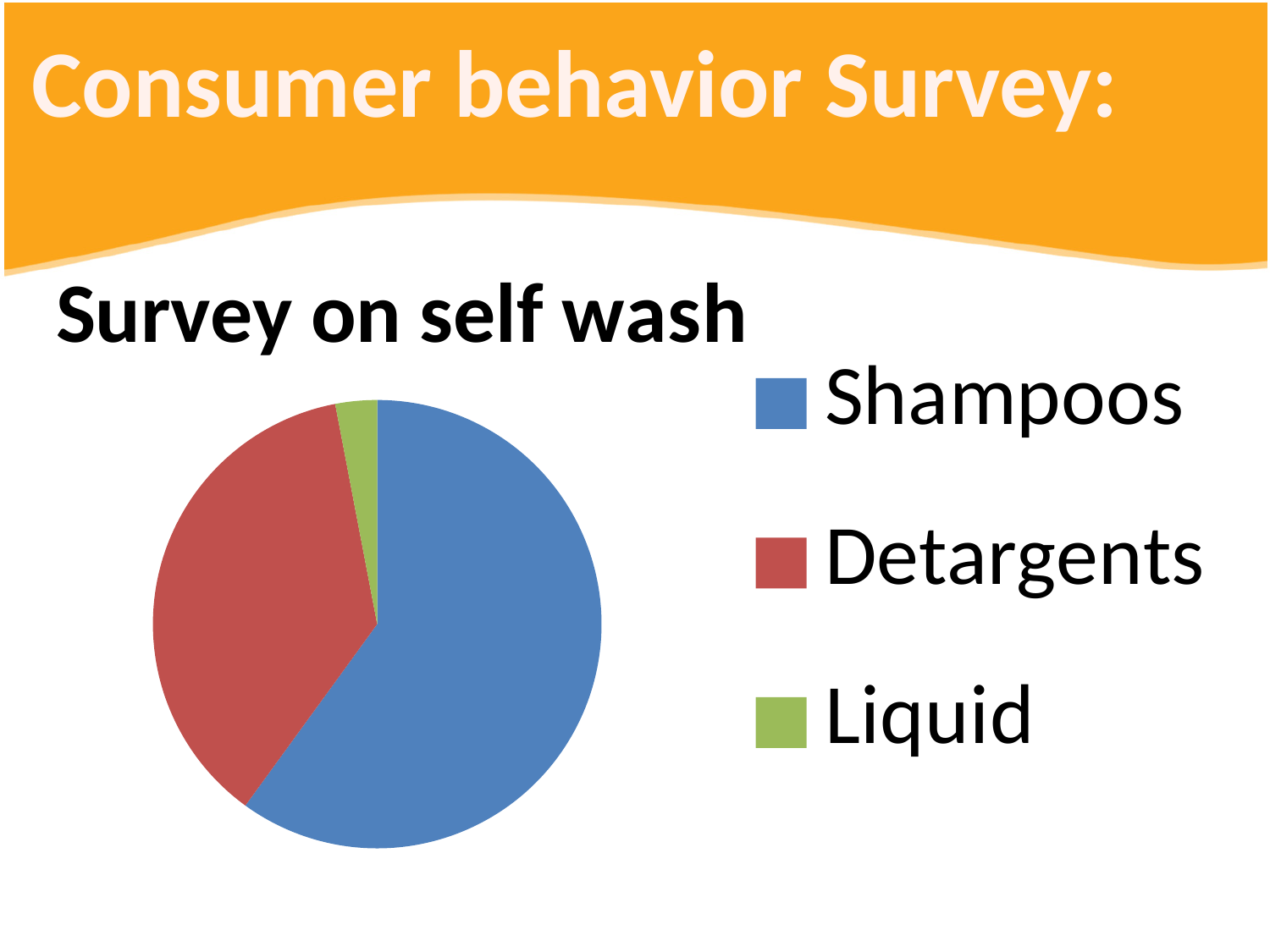
Which category has the largest slice of the pie? Shampoos How many entries does the legend list? 3 What is the title of the chart? Survey on self wash What kind of chart is shown on the slide? pie chart Which category has the smallest slice of the pie? Liquid Which slice is larger, Shampoos or Detargents? Shampoos Which colour represents Liquid in the pie chart? green Which slice is larger, Detargents or Liquid? Detargents How many slices does the pie chart have? 3